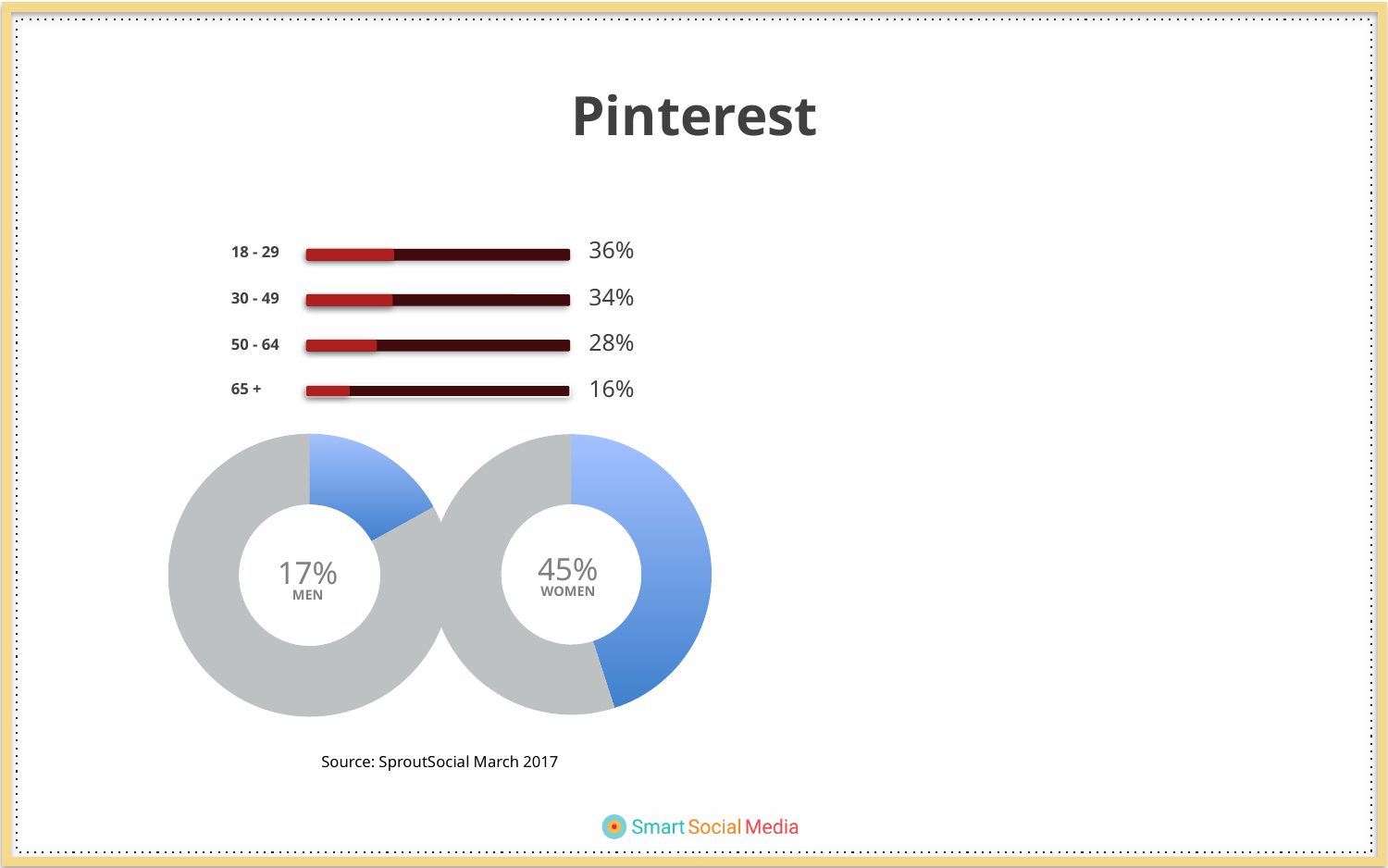
In the age-group bar chart, what is the value for the 65 + group? 16% In the age-group bar chart, which age group has the lowest value? 65 + In the donut charts, what percentage is shown for men? 17% In the age-group bar chart, what is the value for the 18 - 29 group? 36% In the age-group bar chart, which is larger, the value for 30 - 49 or for 50 - 64? 30 - 49 In the donut charts, what is the difference between the women and men percentages? 28% In the age-group bar chart, which age group has the highest value? 18 - 29 What kind of chart shows the age-group data? Bar chart In the donut charts, what percentage is shown for women? 45% How many age groups are shown in the bar chart? 4 In the age-group bar chart, what is the value for the 50 - 64 group? 28% In the age-group bar chart, what is the difference between the 30 - 49 and 65 + values? 18%